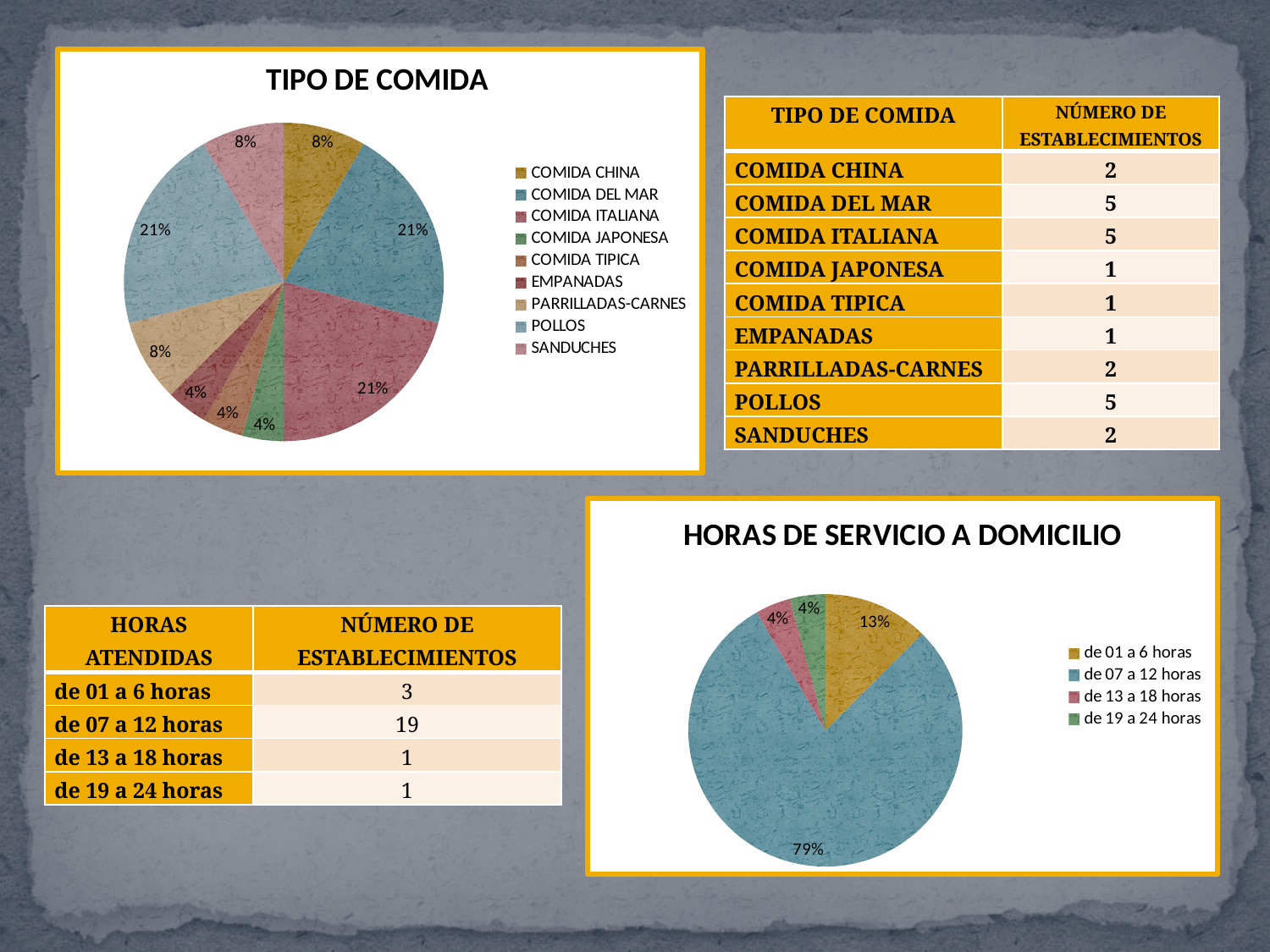
In the HORAS DE SERVICIO A DOMICILIO chart, which category has the largest slice? de 07 a 12 horas In the TIPO DE COMIDA chart, how many categories does the legend list? 9 In the TIPO DE COMIDA chart, what percentage is shown for COMIDA JAPONESA? 4% In the HORAS DE SERVICIO A DOMICILIO chart, what share does de 19 a 24 horas have? 4% In the TIPO DE COMIDA chart, what share of the pie does COMIDA CHINA have? 8% In the HORAS DE SERVICIO A DOMICILIO chart, what percentage is shown for de 01 a 6 horas? 13% In the HORAS DE SERVICIO A DOMICILIO chart, what is the difference in percentage points between de 07 a 12 horas and de 01 a 6 horas? 66% In the TIPO DE COMIDA chart, which is larger, the slice for COMIDA DEL MAR or the slice for SANDUCHES? COMIDA DEL MAR In the HORAS DE SERVICIO A DOMICILIO chart, how many slices does the pie have? 4 In the TIPO DE COMIDA chart, what percentage is shown for POLLOS? 21% What is the title of the pie chart in the lower right of the slide? HORAS DE SERVICIO A DOMICILIO What kind of chart is the TIPO DE COMIDA chart? Pie chart